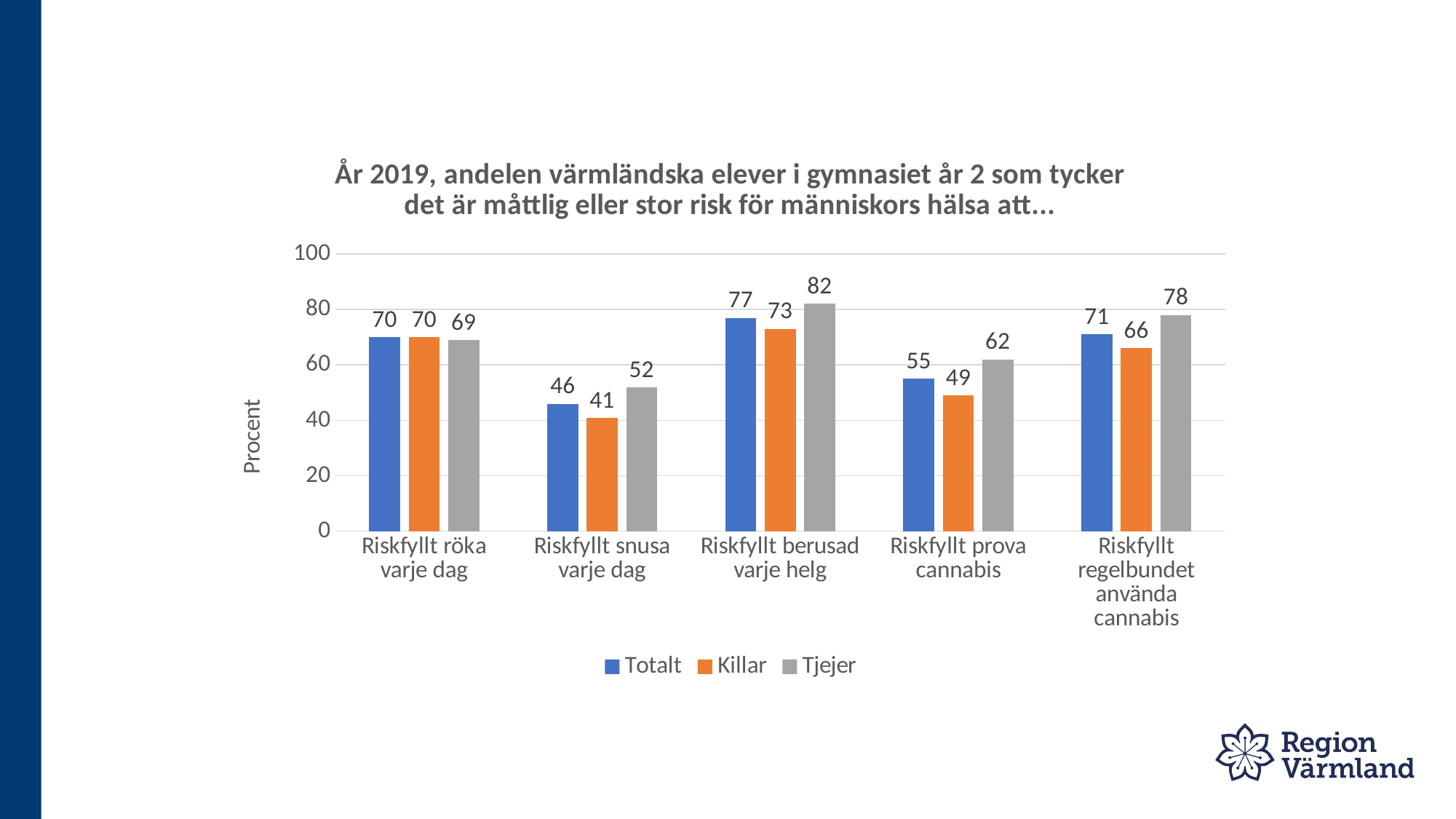
How many categories are shown on the x axis? 5 What is the value for Tjejer in the category "Riskfyllt berusad varje helg"? 82 What kind of chart is shown on the slide? bar chart What is the Totalt value for "Riskfyllt prova cannabis"? 55 What is the difference between the Tjejer and Killar values for "Riskfyllt prova cannabis"? 13 Is the Totalt value for "Riskfyllt snusa varje dag" greater or less than 60? less Which category has the lowest Killar value? Riskfyllt snusa varje dag What is the label of the y axis? Procent How many series does the legend list? 3 Which is larger for "Riskfyllt regelbundet använda cannabis": the Killar value or the Tjejer value? Tjejer What is the value for Killar in the category "Riskfyllt snusa varje dag"? 41 Which category has the highest Totalt value? Riskfyllt berusad varje helg